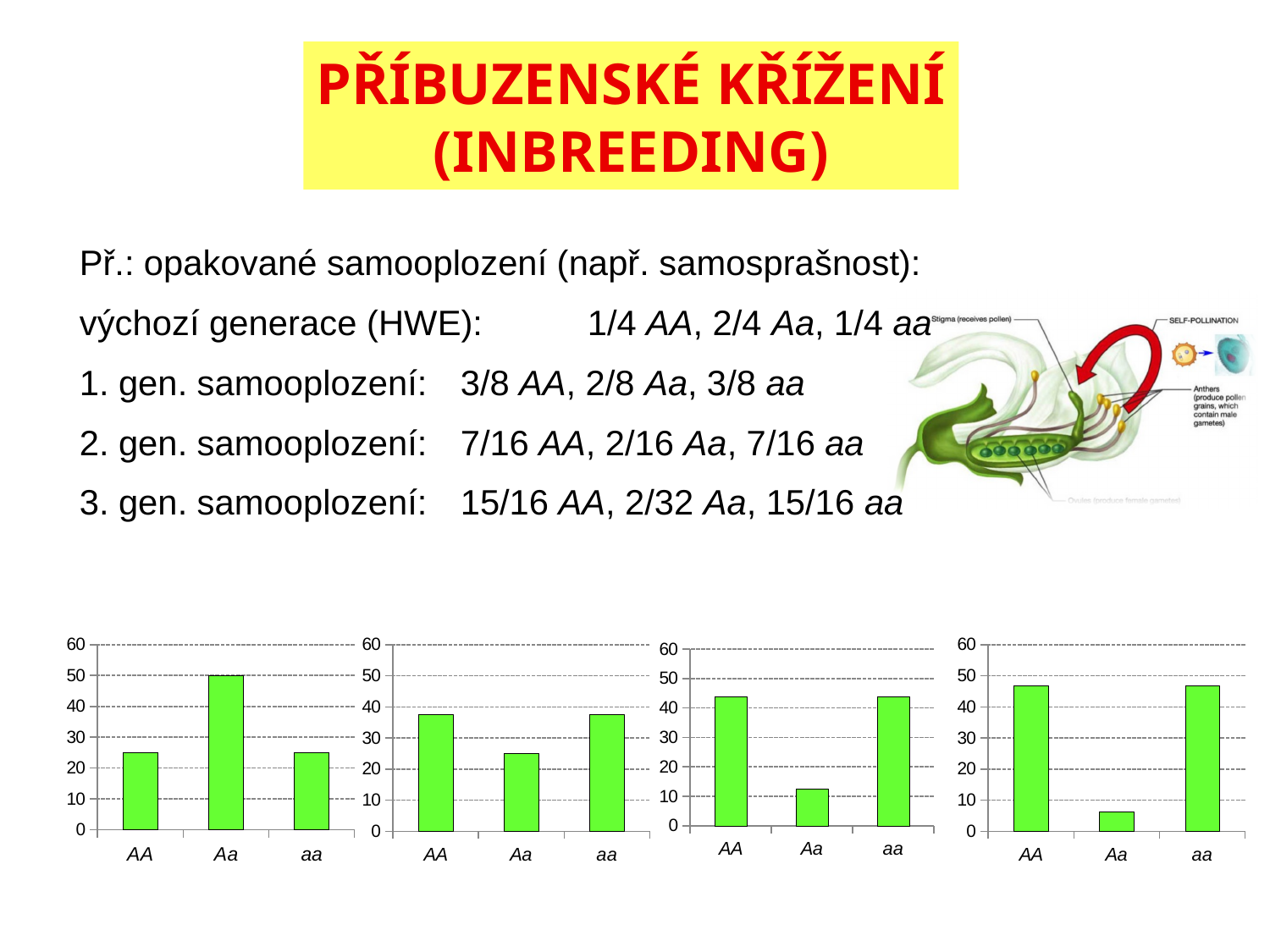
In the third chart from the left, is the value for AA greater or less than 40? greater In the leftmost chart, what is the value for Aa? 50 How many categories are shown on the x axis of the leftmost chart? 3 In the second chart from the left, which category has the lowest value? Aa In the rightmost chart, is the value for aa greater or less than 40? greater In the second chart from the left, which is larger, the value for AA or the value for Aa? AA What kind of chart is the leftmost chart? bar chart In the rightmost chart, is the value for Aa greater or less than 10? less In the rightmost chart, which category has the lowest value? Aa In the leftmost chart, which category has the highest value? Aa